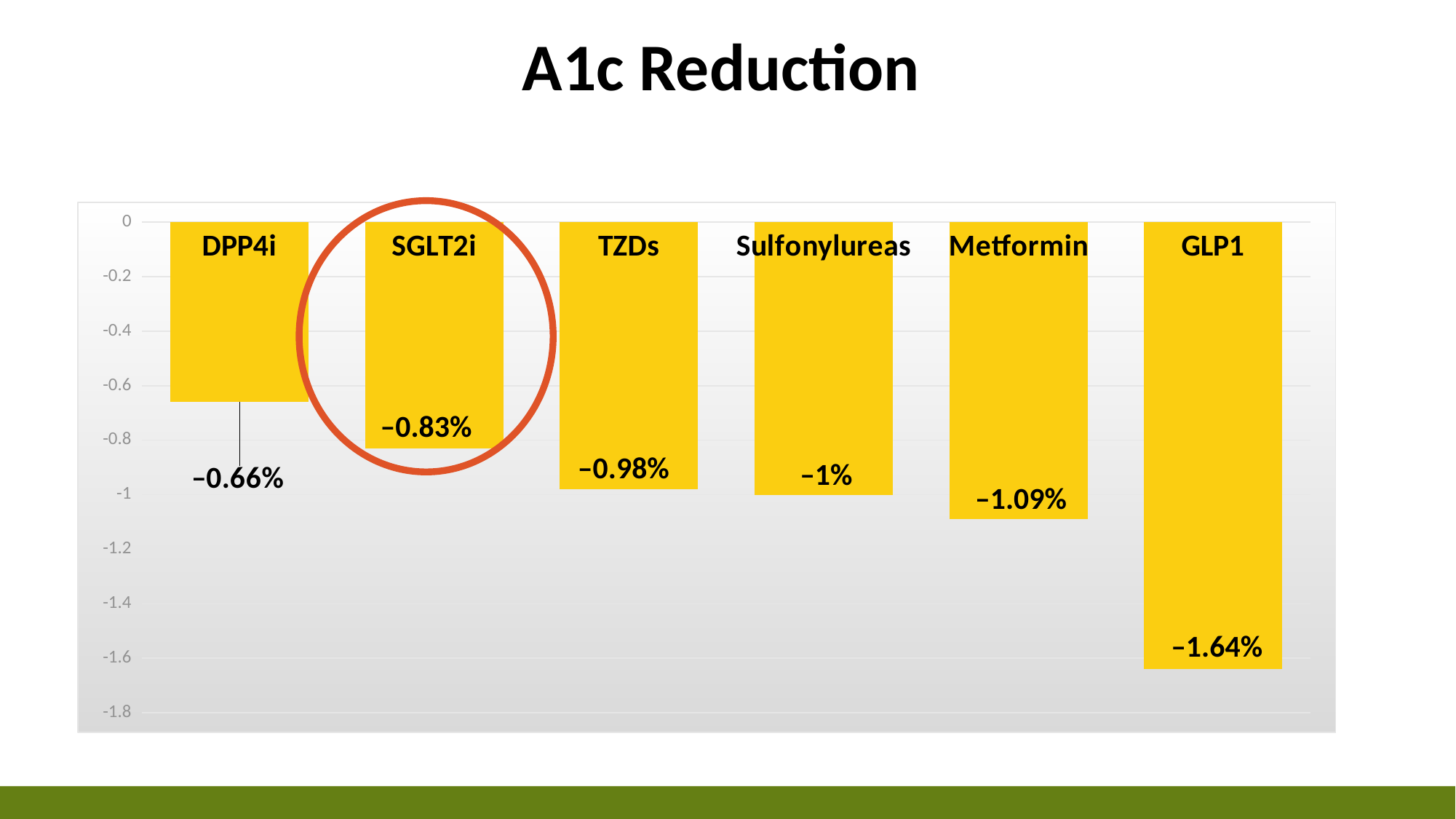
Which category's bar is highlighted with a red circle? SGLT2i Which category shows the smallest A1c reduction (the value closest to 0)? DPP4i By how many percentage points does the GLP1 reduction exceed the DPP4i reduction in magnitude? 0.98 What kind of chart is shown on the slide? Bar chart What is the A1c reduction value shown for SGLT2i? -0.83% What is the value shown for Metformin? -1.09% What is the value shown for DPP4i? -0.66% Which has the larger A1c reduction in magnitude, TZDs or SGLT2i? TZDs Which category shows the largest A1c reduction (the lowest value on the axis)? GLP1 How many drug categories are plotted in the chart? 6 What is the value shown for Sulfonylureas? -1% Is the value for Metformin greater or less than -1? less